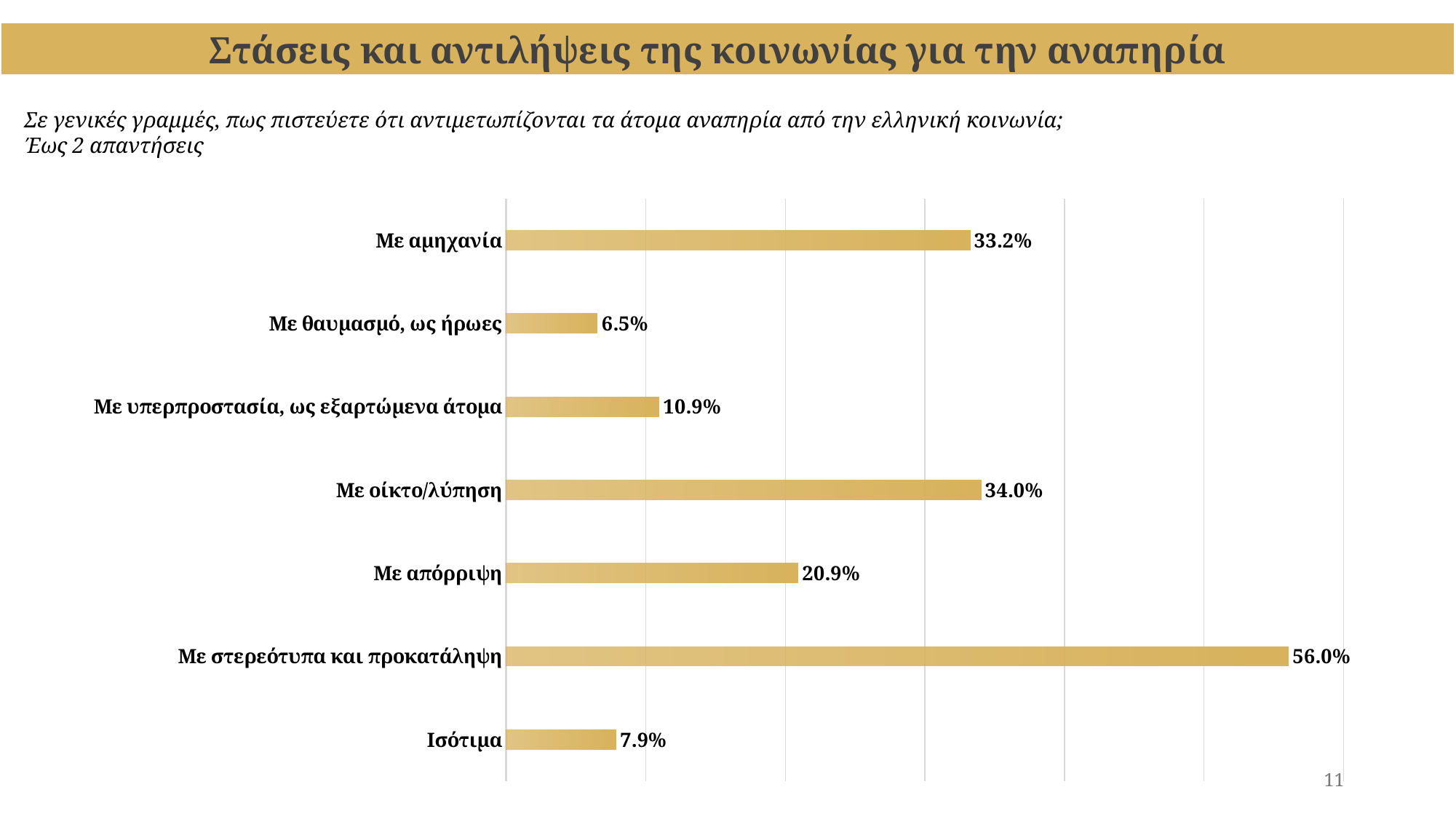
What is the value for "Με στερεότυπα και προκατάληψη"? 56.0% What is the difference between the values for "Με στερεότυπα και προκατάληψη" and "Με οίκτο/λύπηση"? 22.0% What is the value for "Ισότιμα"? 7.9% Which is larger, the value for "Με απόρριψη" or the value for "Ισότιμα"? Με απόρριψη What is the value for "Με υπερπροστασία, ως εξαρτώμενα άτομα"? 10.9% Which category has the lowest value? Με θαυμασμό, ως ήρωες Which category has the highest value? Με στερεότυπα και προκατάληψη What is the value for "Με αμηχανία"? 33.2% What is the difference between the values for "Με απόρριψη" and "Με υπερπροστασία, ως εξαρτώμενα άτομα"? 10.0% How many categories are shown in the chart? 7 What kind of chart is shown on the slide? Bar chart What is the title of the slide? Στάσεις και αντιλήψεις της κοινωνίας για την αναπηρία